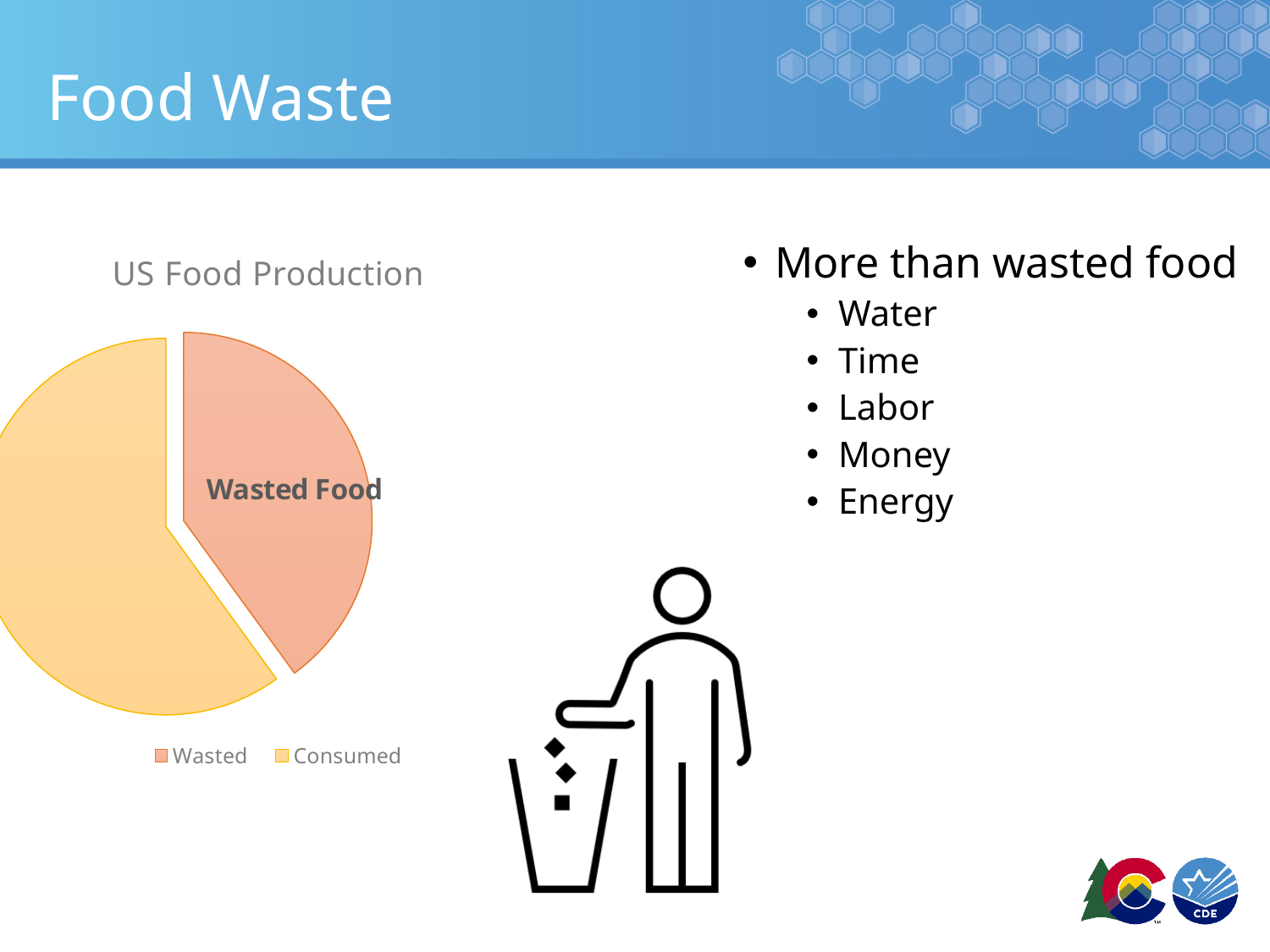
What kind of chart is shown on the slide? Pie chart What text label is printed on the Wasted slice of the pie chart? Wasted Food What is the title of the chart? US Food Production Which slice of the pie chart is the smallest? Wasted How many entries does the chart's legend list? 2 How many slices does the pie chart have? 2 Which is larger in the pie chart, Wasted or Consumed? Consumed Which slice of the pie chart is the largest? Consumed